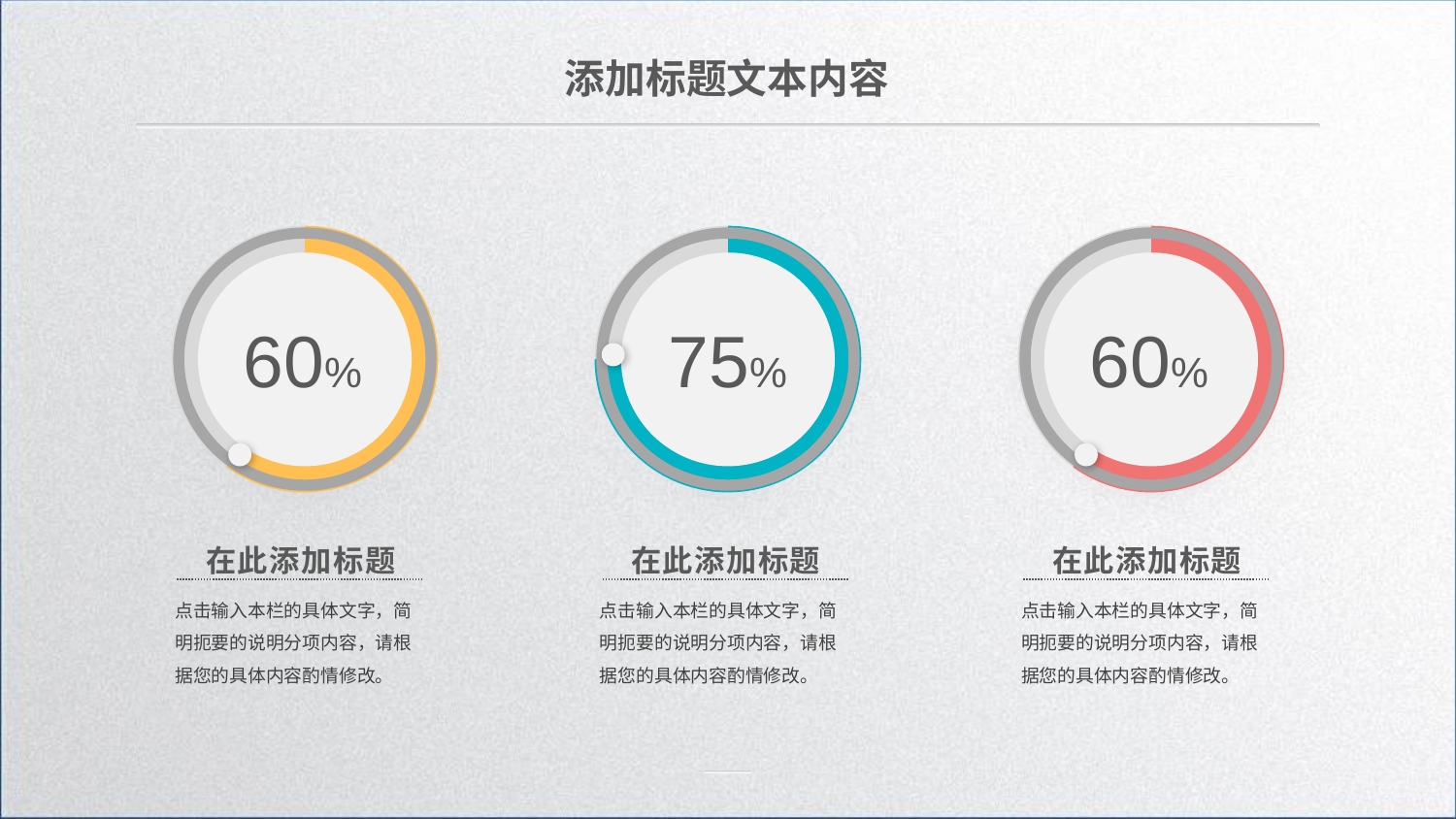
What kind of chart is used to display the percentages on the slide? ring (donut) chart What value is shown in the left ring chart? 60% Do the left and right ring charts show the same value? Yes What colour is the filled arc of the left ring chart? yellow What colour is the filled arc of the middle ring chart? blue What value is shown in the middle ring chart? 75% What is the value shown in the red ring chart? 60% What is the difference between the middle ring chart's value and the left ring chart's value? 15% How many ring charts are on the slide? 3 What value is shown in the right ring chart? 60% Which ring chart shows the highest percentage: left, middle or right? middle Which is larger, the value in the middle ring chart or the value in the right ring chart? middle ring chart